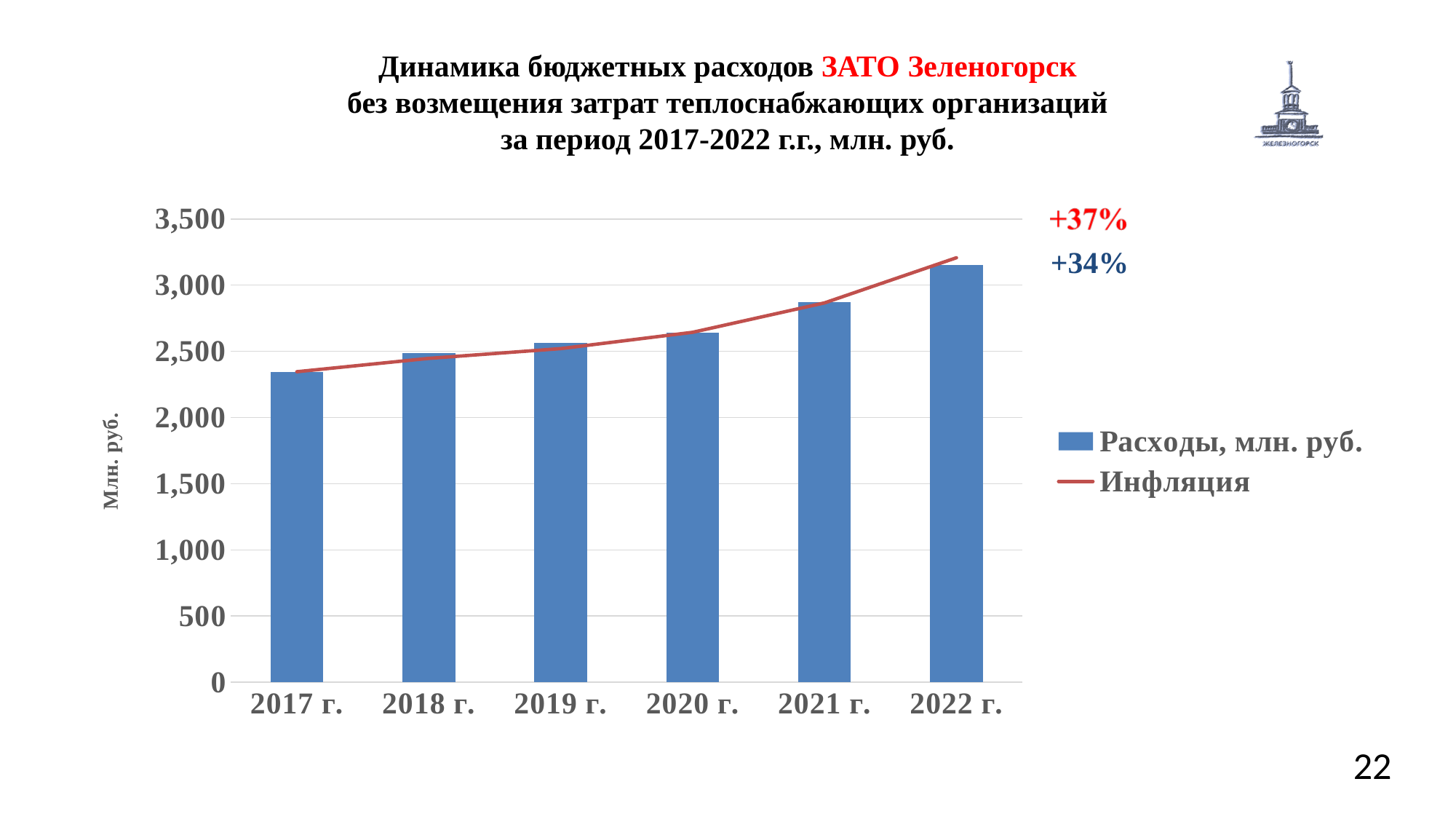
Is the bar for 2022 г. greater or less than 3,000? greater Do the bars for Расходы rise or fall from 2017 г. to 2022 г.? rise Is the bar for 2020 г. greater or less than 3,000? less What are the two legend entries of the chart? Расходы, млн. руб. and Инфляция What kind of chart is shown on the slide? bar chart with a line Which year has the lowest bar for Расходы, млн. руб.? 2017 г. Which year has the highest bar for Расходы, млн. руб.? 2022 г. Which is larger, the bar for 2022 г. or the bar for 2017 г.? 2022 г. How many series does the chart legend list? 2 Is the bar for 2021 г. greater or less than 2,500? greater How many years are shown on the x axis of the chart? 6